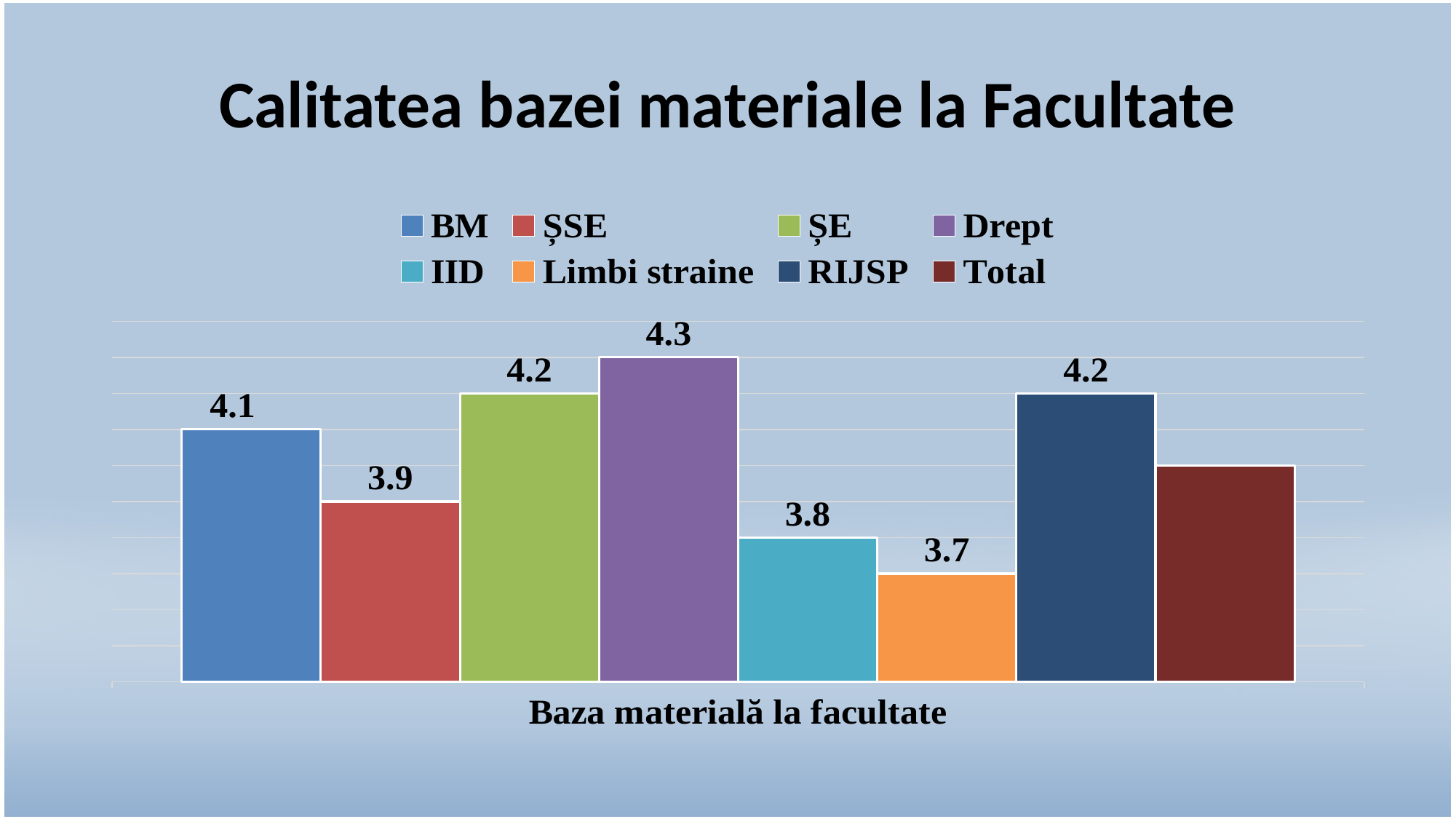
Which is larger, the value for Total or the value for Drept? Drept What kind of chart is shown on the slide? Bar chart What is the value for IID? 3.8 What is the difference between the values for BM and ȘSE? 0.2 What is the difference between the values for Drept and Limbi straine? 0.6 What is the value for Limbi straine? 3.7 Which series has the highest value? Drept Which series has the lowest value? Limbi straine What is the value for BM? 4.1 How many series does the legend list? 8 What is the value for Drept? 4.3 What is the title of the chart? Calitatea bazei materiale la Facultate